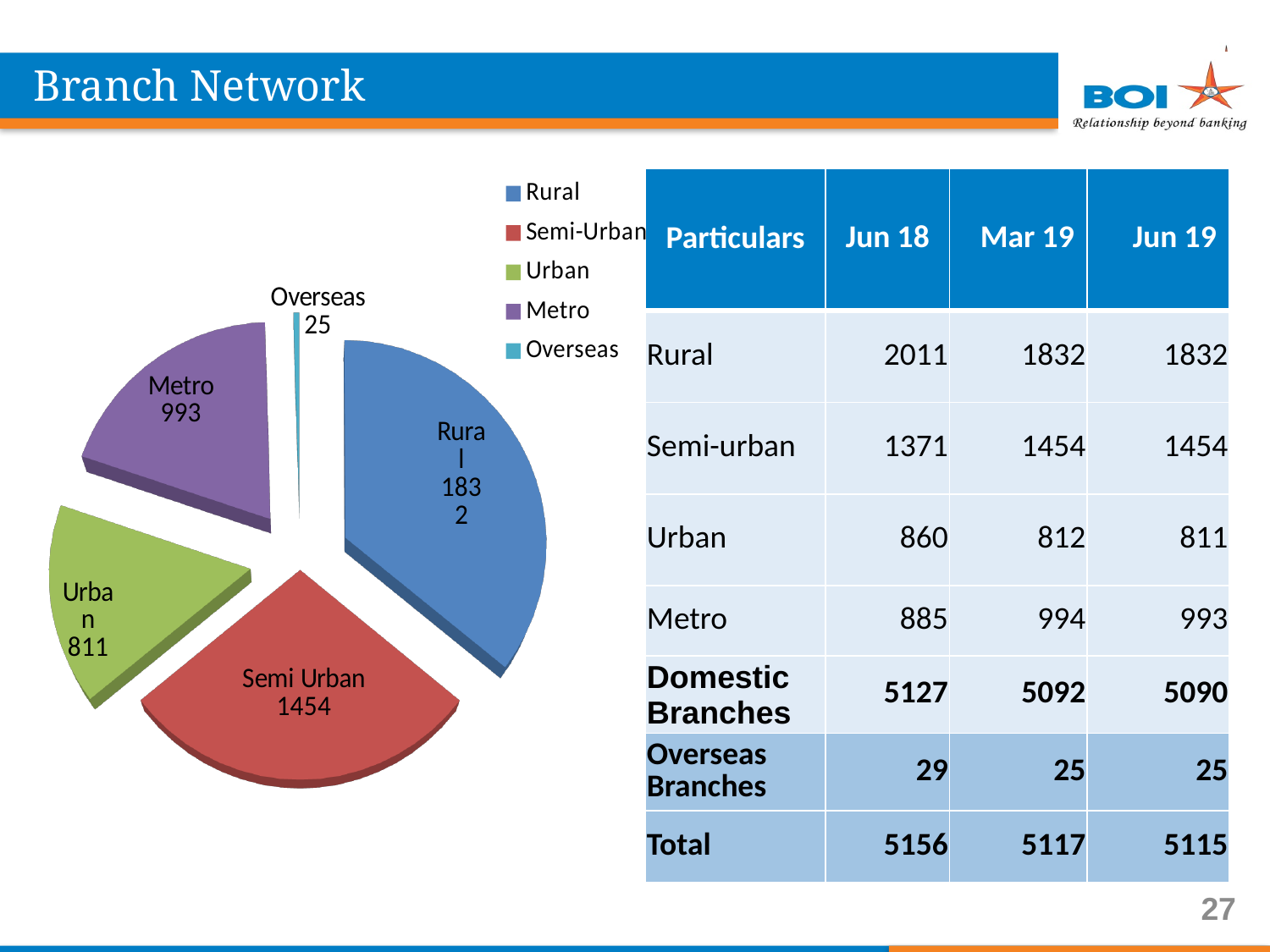
What is the value shown for the Metro slice of the pie chart? 993 In the pie chart, which is larger, Urban or Metro? Metro Which slice of the pie chart has the smallest value? Overseas What colour is the Semi-Urban slice in the pie chart? Red Which slice of the pie chart has the largest value? Rural What is the difference between the Metro and Urban values in the pie chart? 182 What is the value shown for the Semi Urban slice of the pie chart? 1454 How many slices does the pie chart have? 5 What is the value shown for the Overseas slice of the pie chart? 25 What is the difference between the Rural and Semi Urban values in the pie chart? 378 How many entries does the pie chart legend list? 5 What kind of chart is shown on the slide? Pie chart